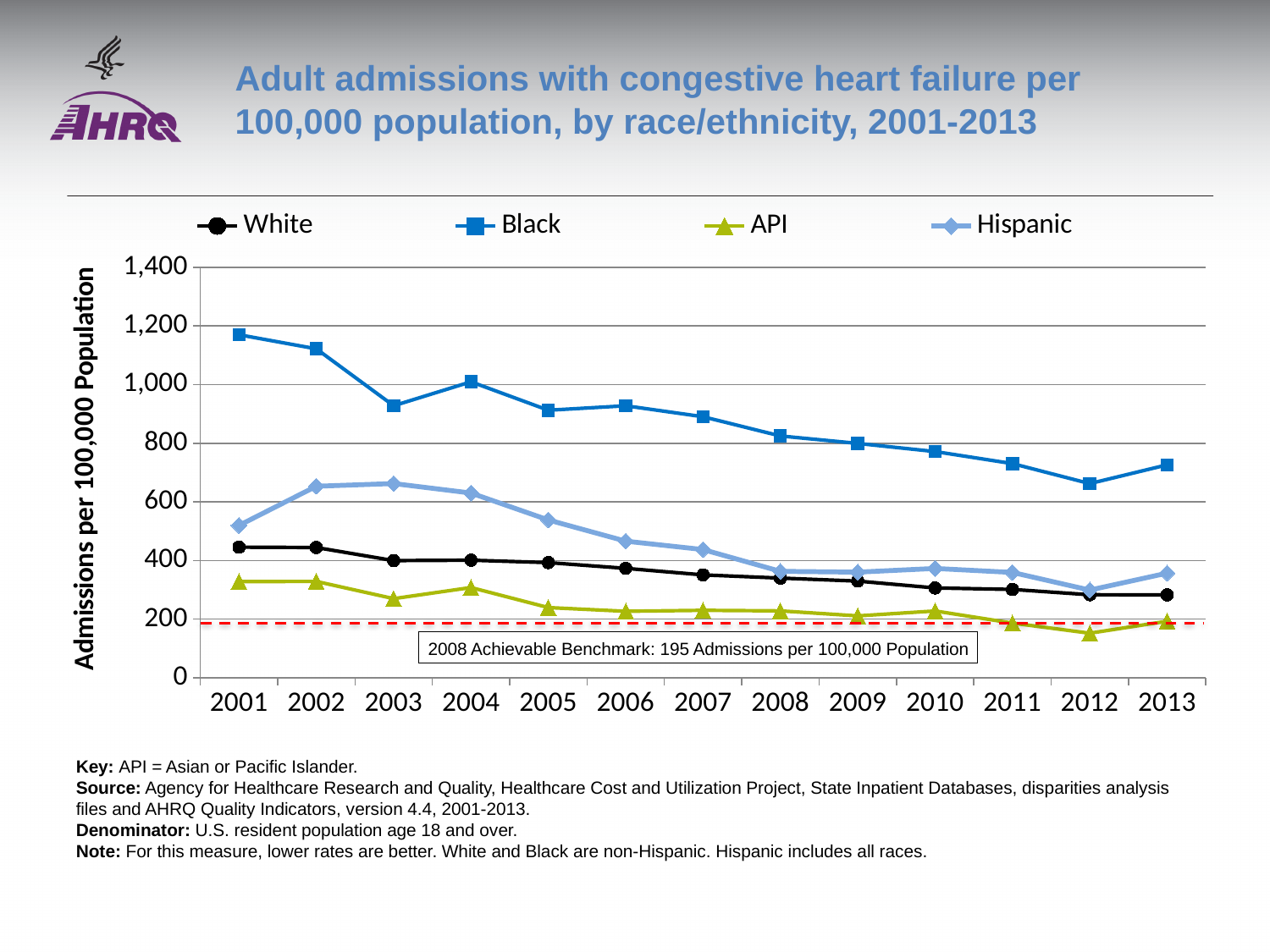
How many series does the legend list? 4 In 2003, which is larger: the value for Hispanic or the value for White? Hispanic Is the value for Black in 2001 greater or less than 1,000? greater What kind of chart is shown on the slide? line chart Is the value for Black in 2012 greater or less than 800? less What is the 2008 achievable benchmark shown on the chart? 195 Admissions per 100,000 Population Is the value for API in 2012 greater or less than 200? less Does the Black series generally rise or fall from 2001 to 2013? fall How many years are plotted along the x axis? 13 Which race/ethnicity group has the highest admission rate in 2001? Black Which race/ethnicity group has the lowest admission rate in 2012? API